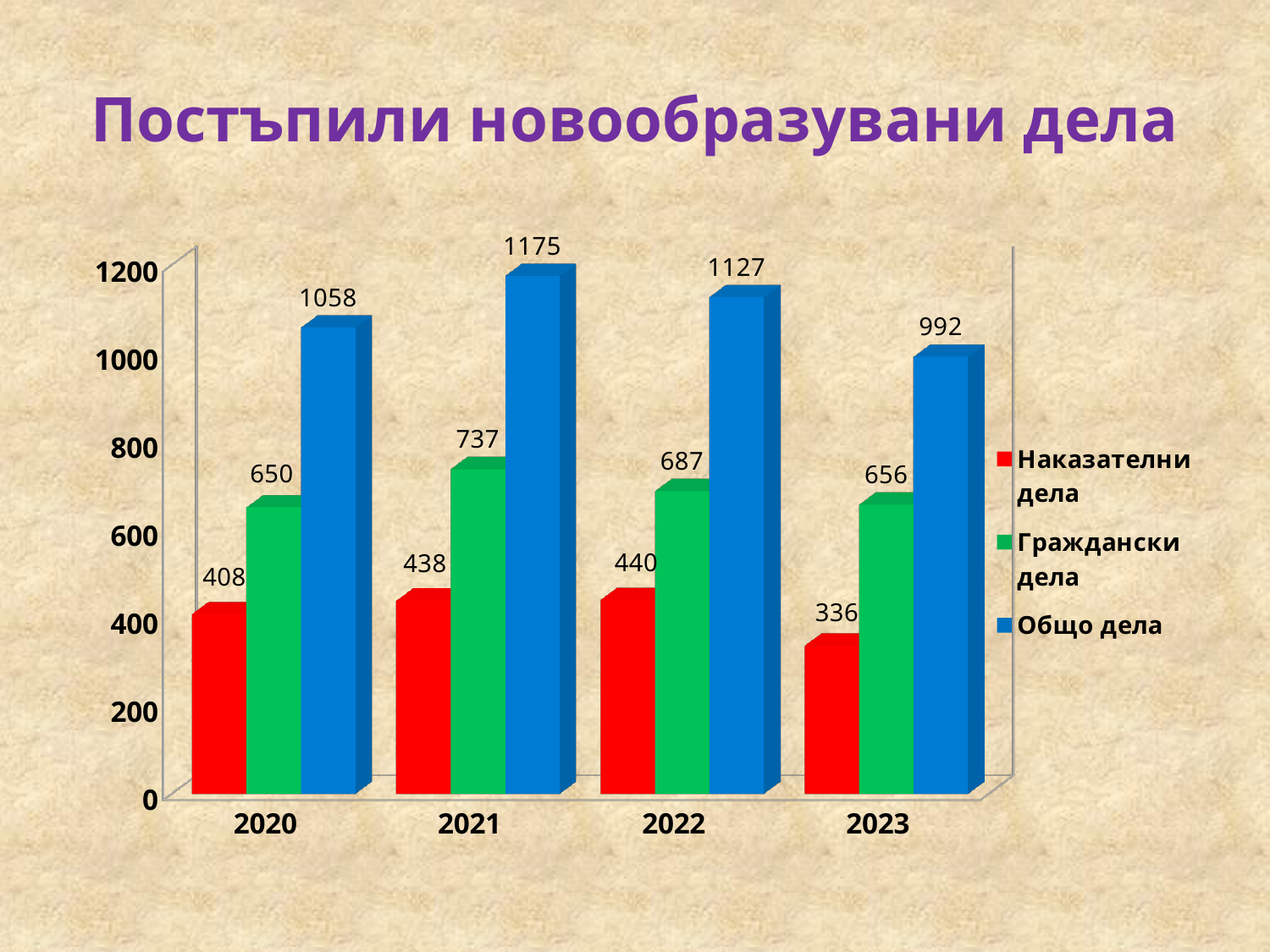
What is the value for Наказателни дела in 2020? 408 What is the difference between Граждански дела in 2021 and in 2020? 87 In which year is Наказателни дела lowest? 2023 What is the value for Общо дела in 2021? 1175 In which year is Общо дела highest? 2021 Is the value for Граждански дела in 2022 greater or less than 600? greater What is the title of the slide? Постъпили новообразувани дела How many years are shown on the x axis? 4 Which is larger: Общо дела in 2022 or Общо дела in 2023? Общо дела in 2022 How many series does the legend list? 3 What is the value for Граждански дела in 2023? 656 What kind of chart is shown on the slide? bar chart